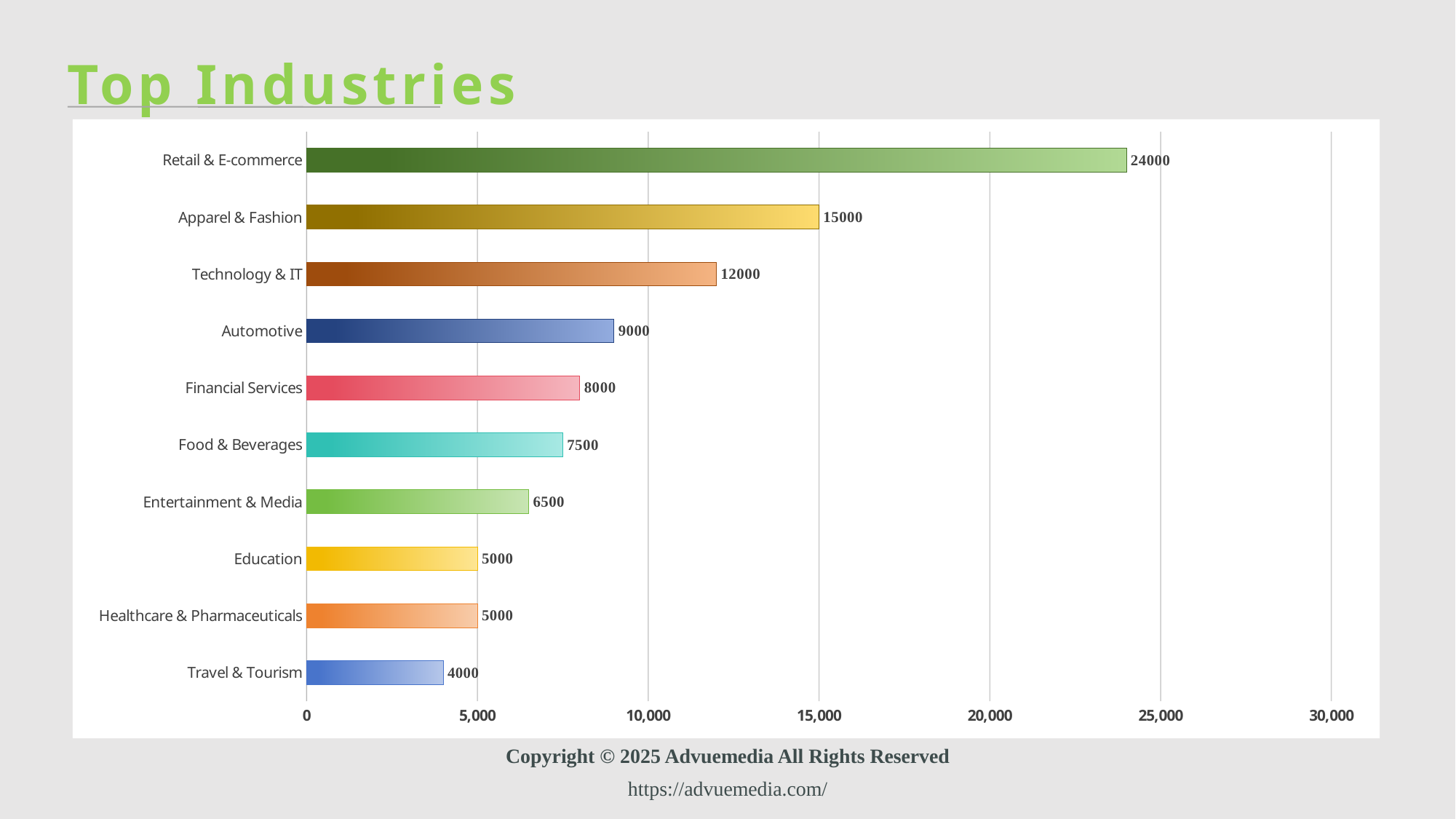
What is the value for Food & Beverages? 7500 Is the value for Technology & IT greater or less than 10,000? greater What is the difference between the values for Apparel & Fashion and Automotive? 6000 What is the value for Technology & IT? 12000 What is the title of the slide? Top Industries What is the difference between the values for Retail & E-commerce and Travel & Tourism? 20000 Which industry has the lowest value? Travel & Tourism What kind of chart is shown on the slide? Bar chart What is the value for Retail & E-commerce? 24000 Which is larger, the value for Financial Services or the value for Entertainment & Media? Financial Services Which industry has the highest value? Retail & E-commerce How many industries are shown in the chart? 10